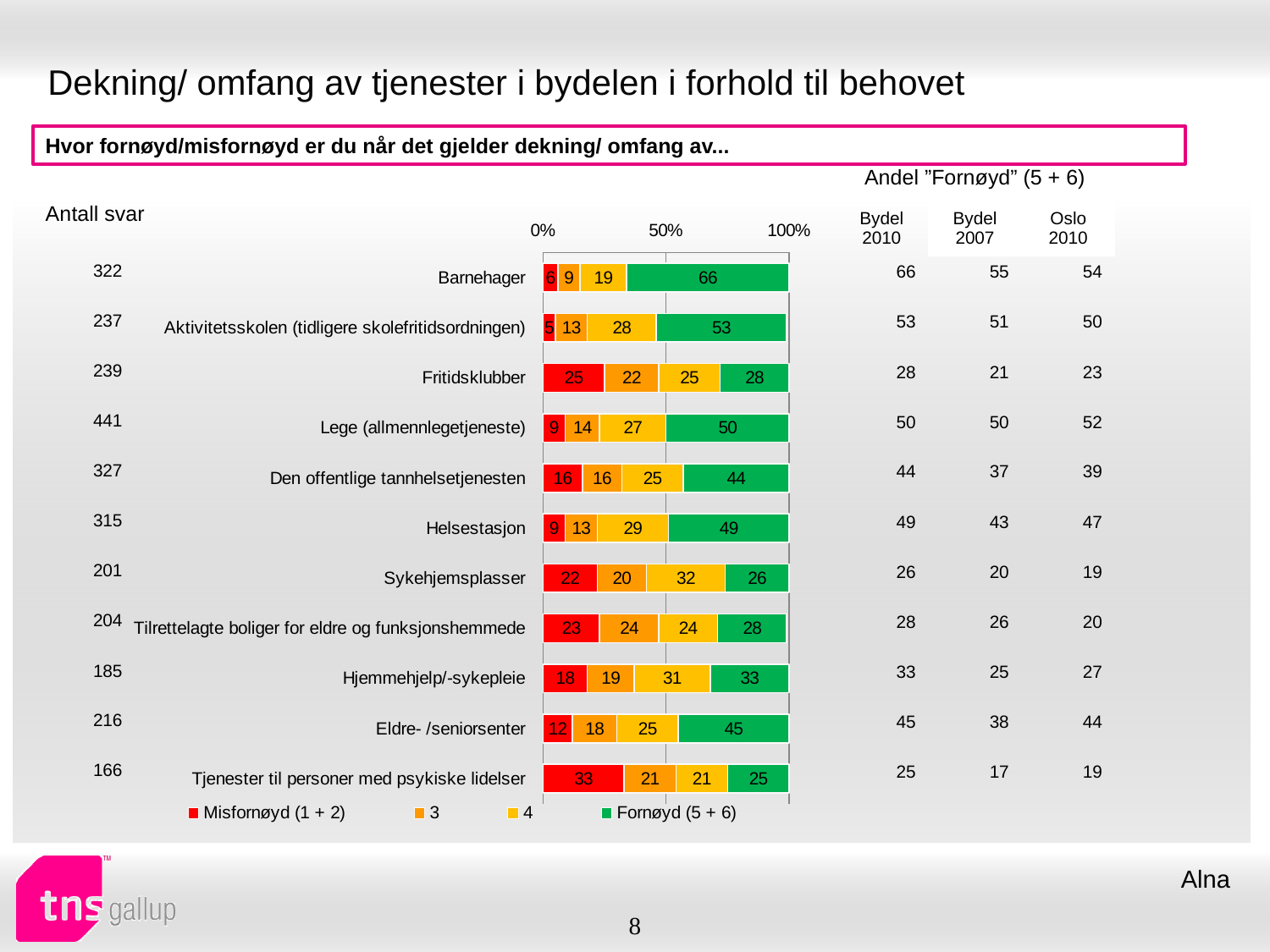
How many series does the legend list? 4 What is the difference between the Fornøyd (5 + 6) values for Barnehager and Aktivitetsskolen (tidligere skolefritidsordningen)? 13 How many categories are shown in the chart? 11 What is the value of series 4 for Sykehjemsplasser? 32 Which has a larger Fornøyd (5 + 6) value, Lege (allmennlegetjeneste) or Helsestasjon? Lege (allmennlegetjeneste) Which category has the highest Fornøyd (5 + 6) value? Barnehager What is the Misfornøyd (1 + 2) value for Tjenester til personer med psykiske lidelser? 33 Which category has the highest Misfornøyd (1 + 2) value? Tjenester til personer med psykiske lidelser What kind of chart is shown on the slide? Stacked bar chart Which category has the lowest Misfornøyd (1 + 2) value? Aktivitetsskolen (tidligere skolefritidsordningen) What percentage of respondents are Fornøyd (5 + 6) with Barnehager? 66 What is the value of series 3 for Fritidsklubber? 22